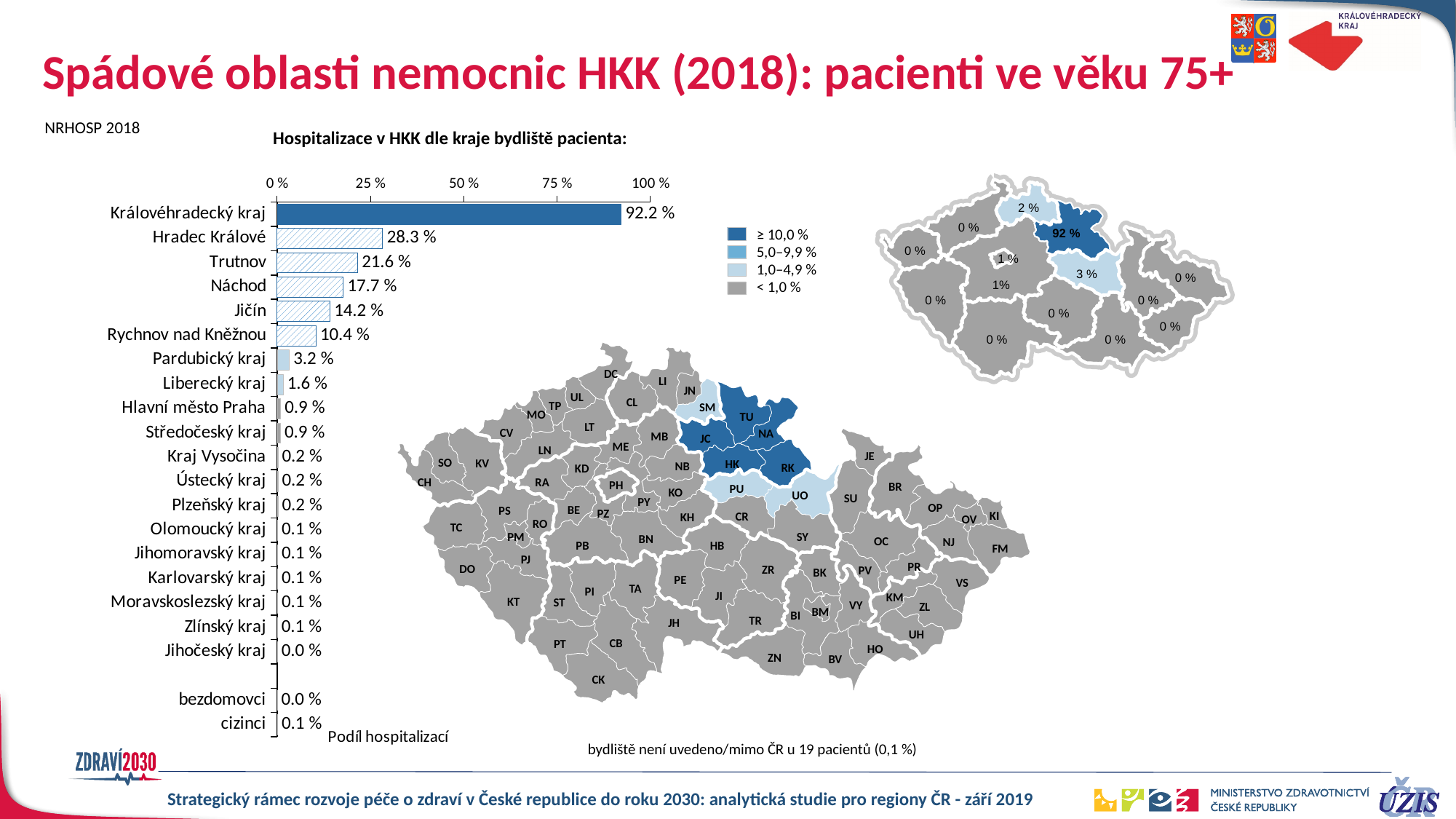
How many categories are listed in the bar chart? 21 What is the difference between the values for Hradec Králové and Trutnov in the bar chart? 6.7 % What is the value for Pardubický kraj in the bar chart? 3.2 % Which category has the highest value in the bar chart? Královéhradecký kraj What is the value for Trutnov in the bar chart? 21.6 % Is the value for Královéhradecký kraj in the bar chart greater or less than 75 %? greater What is the value for Rychnov nad Kněžnou in the bar chart? 10.4 % Which has a larger value in the bar chart, Náchod or Jičín? Náchod What is the value for Královéhradecký kraj in the bar chart? 92.2 % What is the value for cizinci in the bar chart? 0.1 % What is the label shown below the bar chart's axis? Podíl hospitalizací What type of chart is shown under the title 'Hospitalizace v HKK dle kraje bydliště pacienta'? bar chart